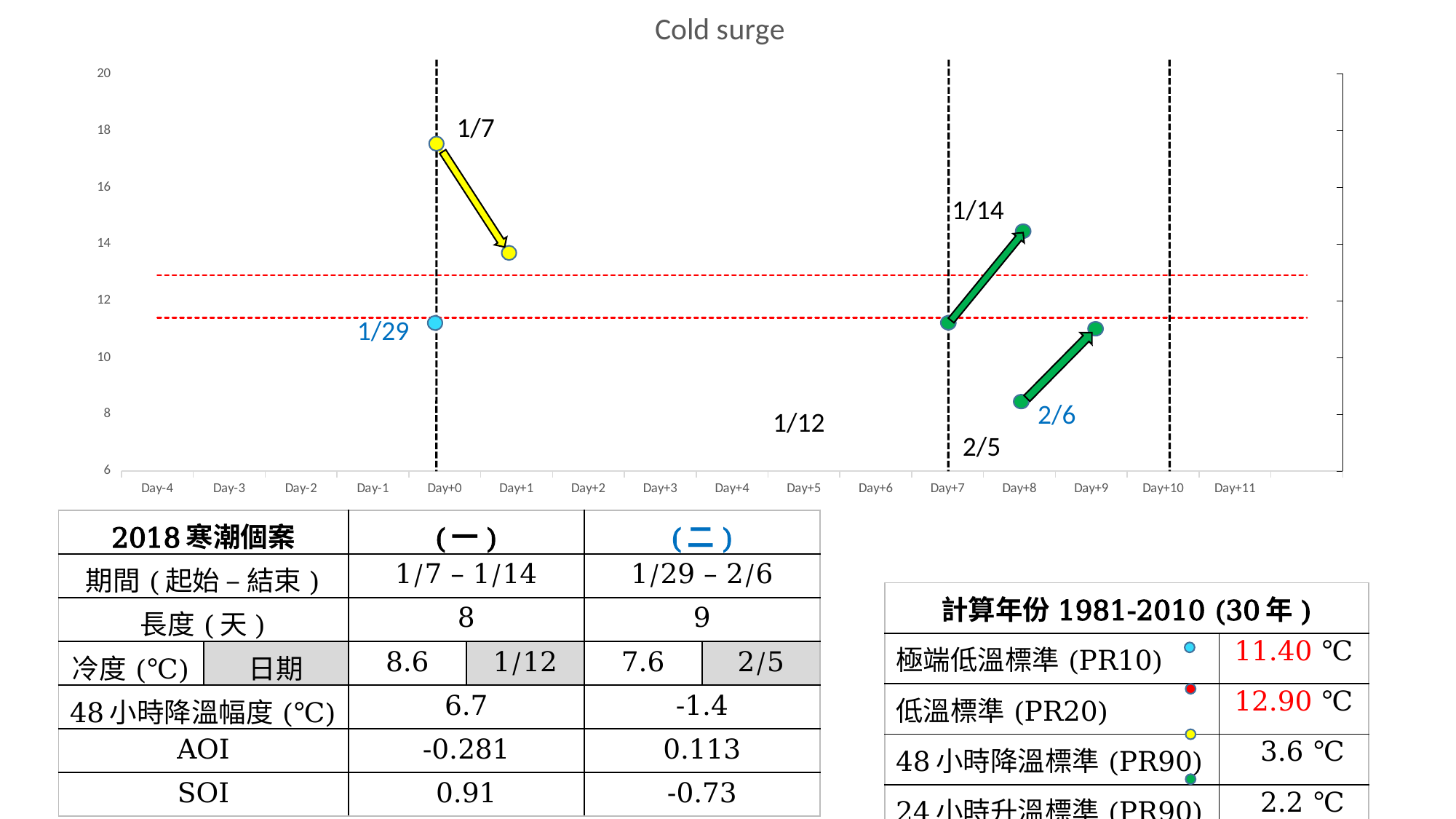
What is the title of the chart? Cold surge Is the value of the point labelled 1/7 greater or less than 16? greater Does the yellow arrow starting at Day+0 rise or fall toward Day+1? fall Is the value of the point labelled 1/29 greater or less than 12? less What is the first category label on the x axis of the chart? Day-4 What kind of chart is shown on the slide? line chart Does the green arrow starting at Day+7 rise or fall toward Day+8? rise Is the value of the point labelled 2/6 greater or less than 12? less Which point is higher on the chart, the one labelled 1/14 or the one labelled 2/6? 1/14 Which point is higher on the chart, the one labelled 1/7 or the one labelled 1/29? 1/7 How many day categories are labelled along the x axis of the chart? 16